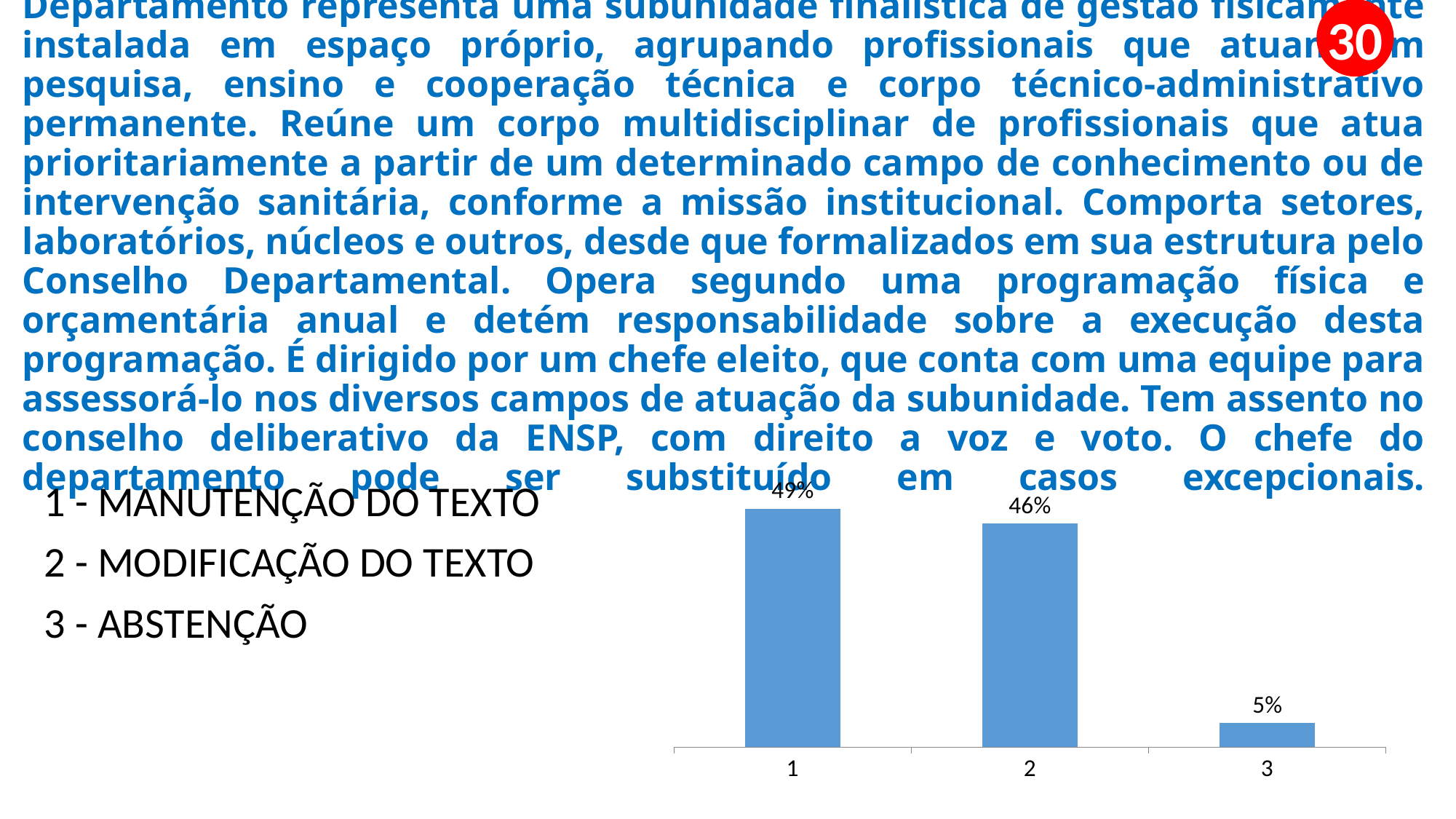
How many categories are plotted in the bar chart? 3 What is the value shown for category 1 in the bar chart? 49% Do the values rise or fall from category 1 to category 3 along the x axis? fall What is the difference between the values for category 1 and category 2? 3% What is the difference between the values for category 2 and category 3? 41% Which category has the highest value in the bar chart? 1 What colour are the bars in the chart? blue Which is larger, the value for category 1 or the value for category 3? category 1 Which category has the lowest value in the bar chart? 3 What is the value shown for category 2 in the bar chart? 46% What is the value shown for category 3 in the bar chart? 5% What kind of chart is shown on the slide? bar chart